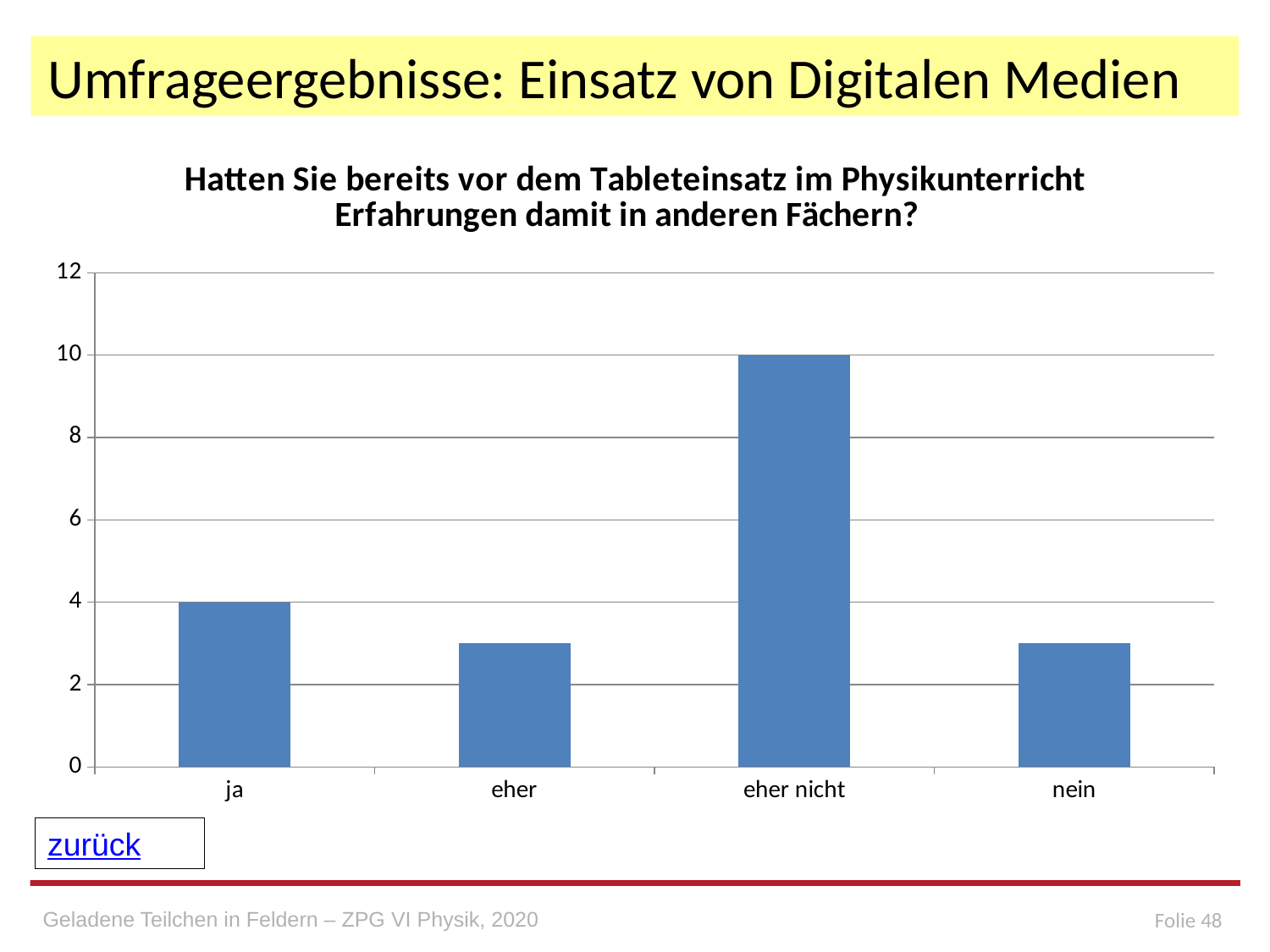
What is the difference between the values for "eher nicht" and "ja"? 6 Which is larger, the value for "eher nicht" or the value for "nein"? eher nicht How many categories are shown on the x axis of the chart? 4 What is the value for "ja"? 4 Is the value for "nein" greater or less than 2? greater What is the value for "eher nicht"? 10 What kind of chart is shown on the slide? bar chart Is the value for "eher" greater or less than 4? less Which is larger, the value for "ja" or the value for "eher"? ja Which category has the highest value in the chart? eher nicht Is the value for "eher nicht" greater or less than 8? greater What is the title of the chart? Hatten Sie bereits vor dem Tableteinsatz im Physikunterricht Erfahrungen damit in anderen Fächern?